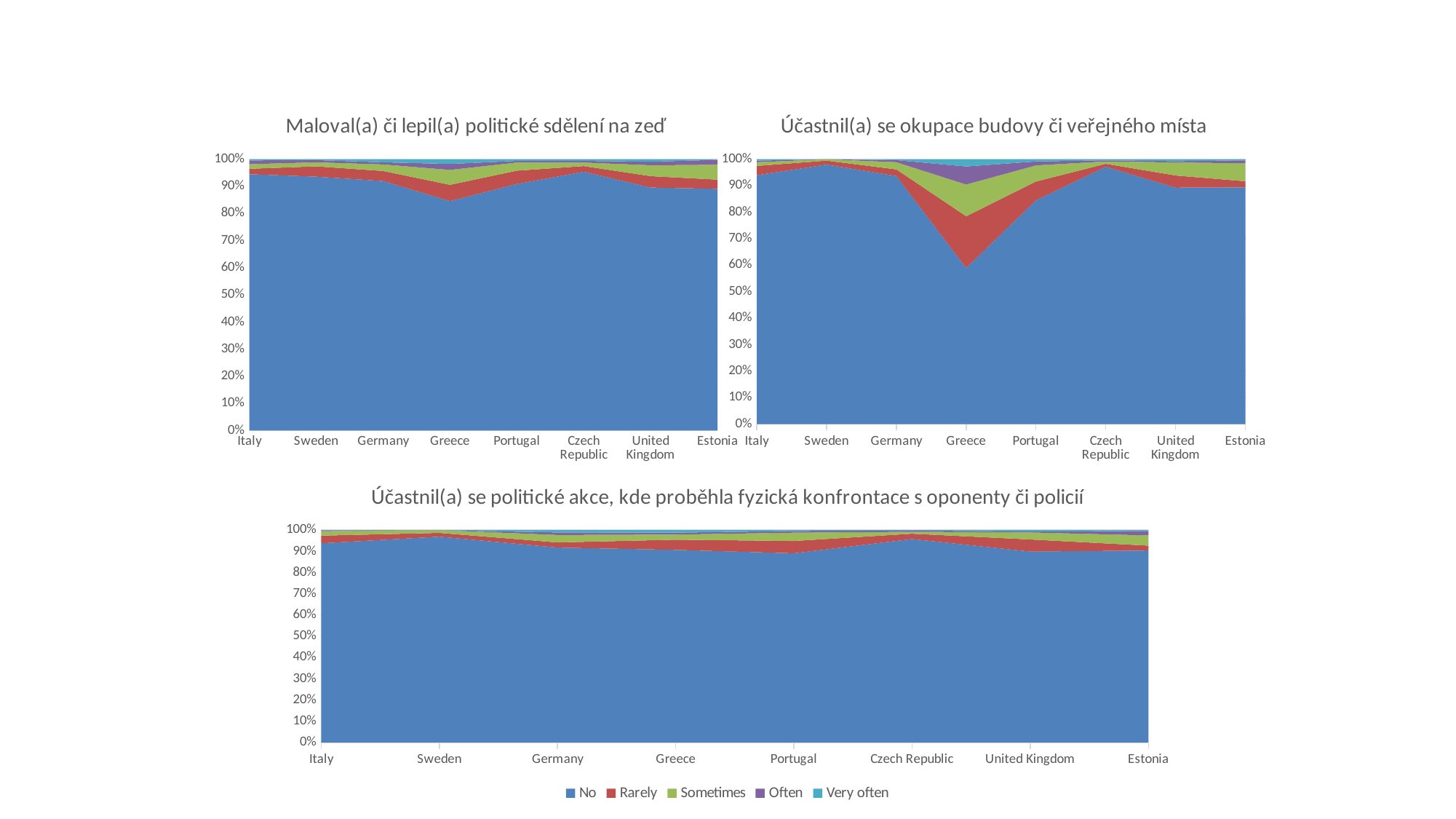
In the chart titled "Maloval(a) či lepil(a) politické sdělení na zeď", which country has the lowest share of "No"? Greece In the chart titled "Maloval(a) či lepil(a) politické sdělení na zeď", is the "No" share for Greece greater or less than 90%? less What kind of chart is the chart titled "Maloval(a) či lepil(a) politické sdělení na zeď"? Stacked area chart In the chart titled "Účastnil(a) se okupace budovy či veřejného místa", which country has the lowest share of "No"? Greece How many countries are shown on the x axis of the chart titled "Účastnil(a) se okupace budovy či veřejného místa"? 8 In the chart titled "Účastnil(a) se okupace budovy či veřejného místa", is the "No" share for Greece greater or less than 70%? less In the chart titled "Maloval(a) či lepil(a) politické sdělení na zeď", is the "No" share for Italy greater or less than 90%? greater What is the title of the bottom chart on the slide? Účastnil(a) se politické akce, kde proběhla fyzická konfrontace s oponenty či policií In the chart titled "Účastnil(a) se okupace budovy či veřejného místa", which country has a larger "No" share, Sweden or Greece? Sweden Which series is shown in blue in the legend? No How many series does the legend at the bottom of the slide list? 5